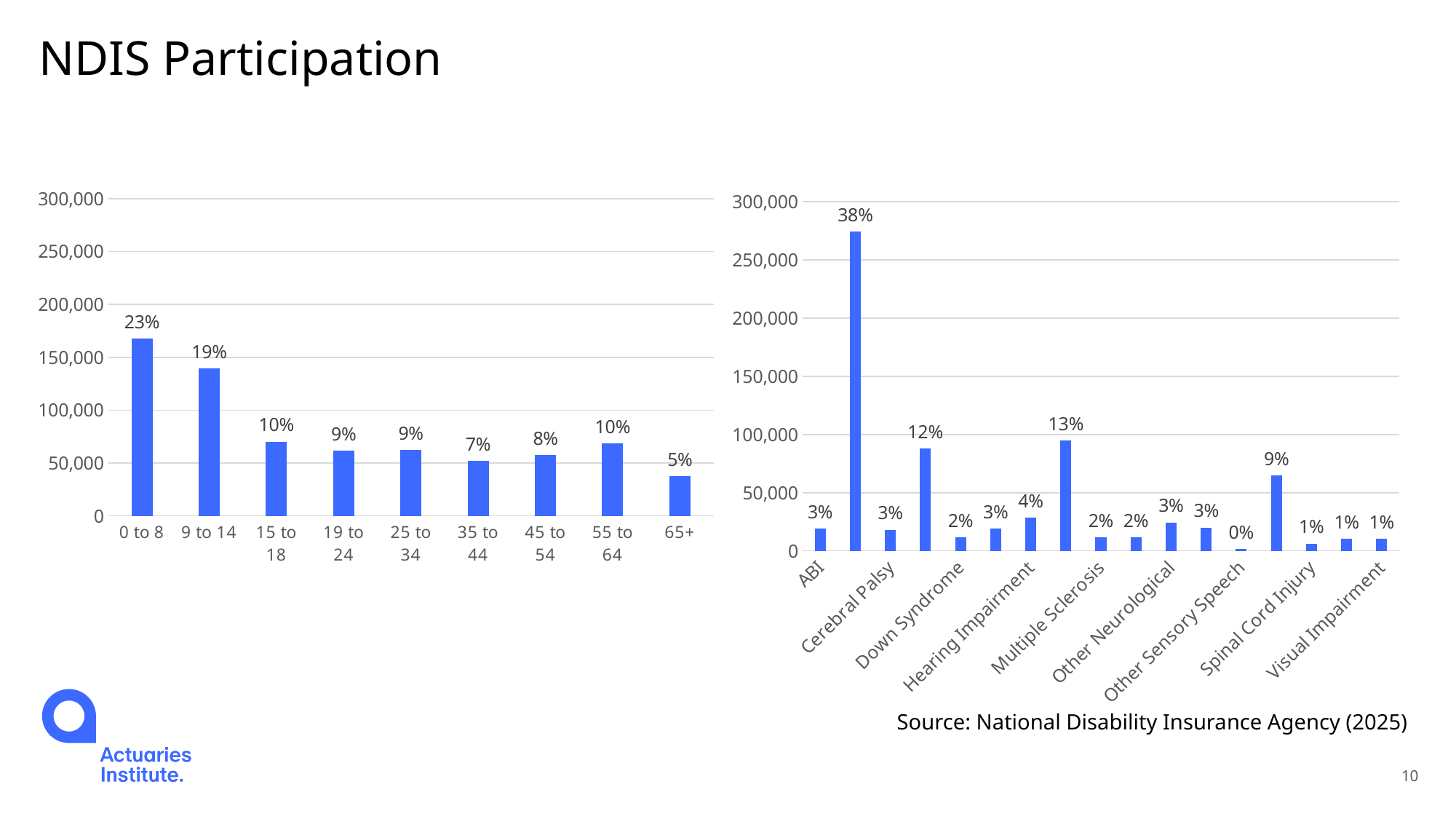
On the left chart, is the value for the 9 to 14 age group greater or less than 150,000? less On the right chart, what percentage label is shown for Hearing Impairment? 4% On the left chart, which age group has the lowest value? 65+ On the right chart, which is larger: the value for Hearing Impairment or the value for Down Syndrome? Hearing Impairment On the left chart, what percentage label is shown for the 0 to 8 age group? 23% What kind of chart is the left chart on the slide? bar chart On the right chart, is the value for Multiple Sclerosis greater or less than 50,000? less On the right chart, what percentage label is shown for Other Sensory Speech? 0% On the left chart, what is the difference in percentage points between the 0 to 8 group and the 65+ group? 18% On the left chart, which age group has the highest value? 0 to 8 On the left chart, what percentage label is shown for the 35 to 44 age group? 7% On the left chart, how many age-group categories are shown? 9